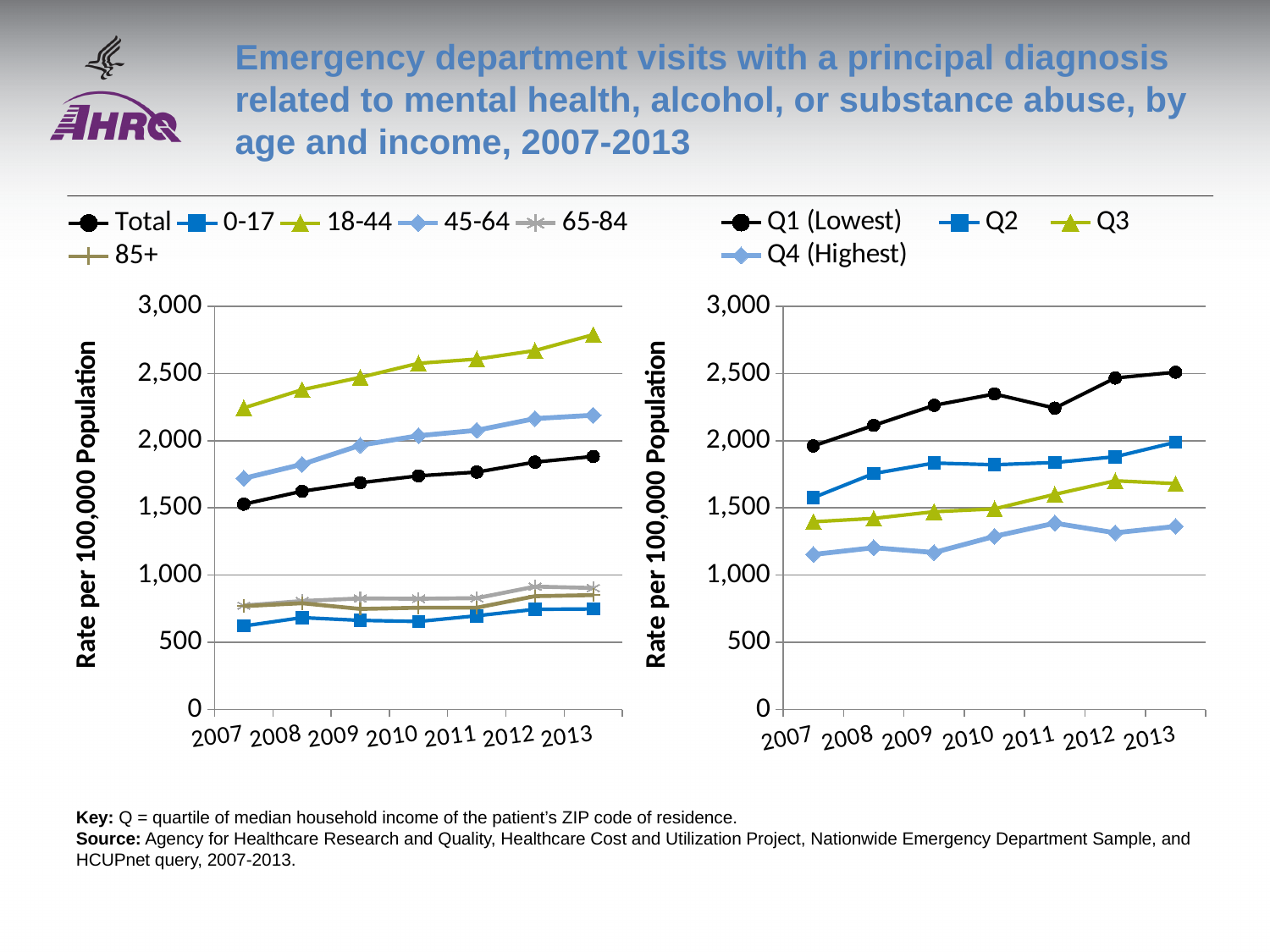
What kind of chart is the left chart on the slide? line chart In the right chart, is the value for Q3 in 2007 greater or less than 1,500? less In the left chart, which age group has the highest rate in 2013? 18-44 In the right chart, which income quartile has the lowest rate in 2007? Q4 (Highest) How many years are shown on the x axis of the right chart? 7 How many series does the legend of the right chart list? 4 In the left chart, is the value for the 18-44 age group in 2013 greater or less than 2,500? greater How many series does the legend of the left chart list? 6 In the left chart, is the value for the 45-64 age group in 2013 greater or less than 2,000? greater In the left chart, which age group has the lowest rate in 2007? 0-17 In the left chart, does the rate for the 18-44 age group rise or fall from 2007 to 2013? rise In the right chart, which income quartile has the highest rate in 2013? Q1 (Lowest)